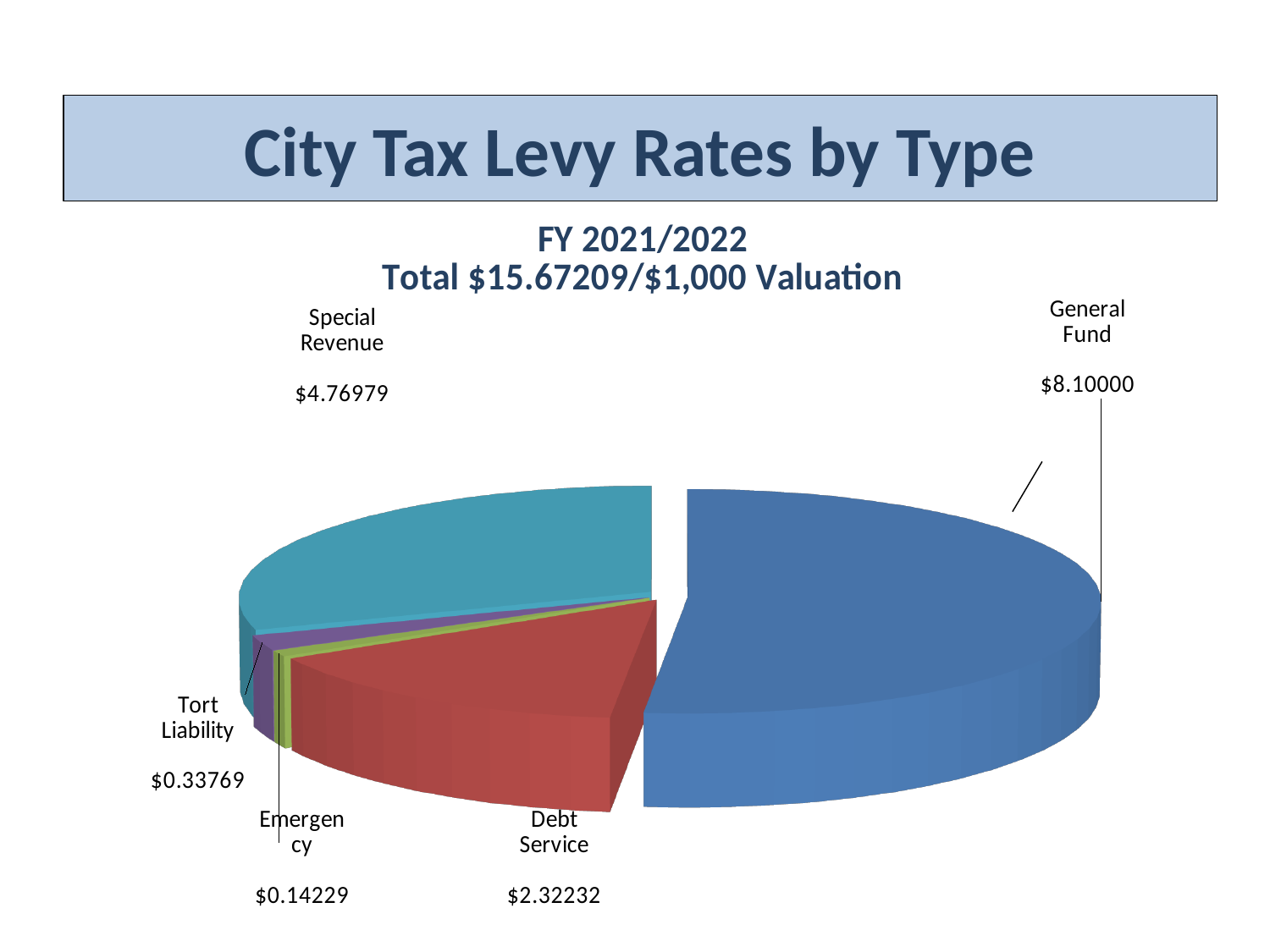
Which levy type has the lowest rate? Emergency Which levy type has the highest rate? General Fund How many levy types are shown in the pie chart? 5 What is the tax levy rate for Tort Liability? $0.33769 What is the difference between the General Fund rate and the Special Revenue rate? $3.33021 What is the tax levy rate for Emergency? $0.14229 What kind of chart is shown on the slide? Pie chart What is the tax levy rate for Debt Service? $2.32232 Which is larger, the Debt Service rate or the Tort Liability rate? Debt Service What is the tax levy rate for the General Fund? $8.10000 What is the tax levy rate for Special Revenue? $4.76979 What is the total levy rate per $1,000 valuation shown in the chart title? $15.67209